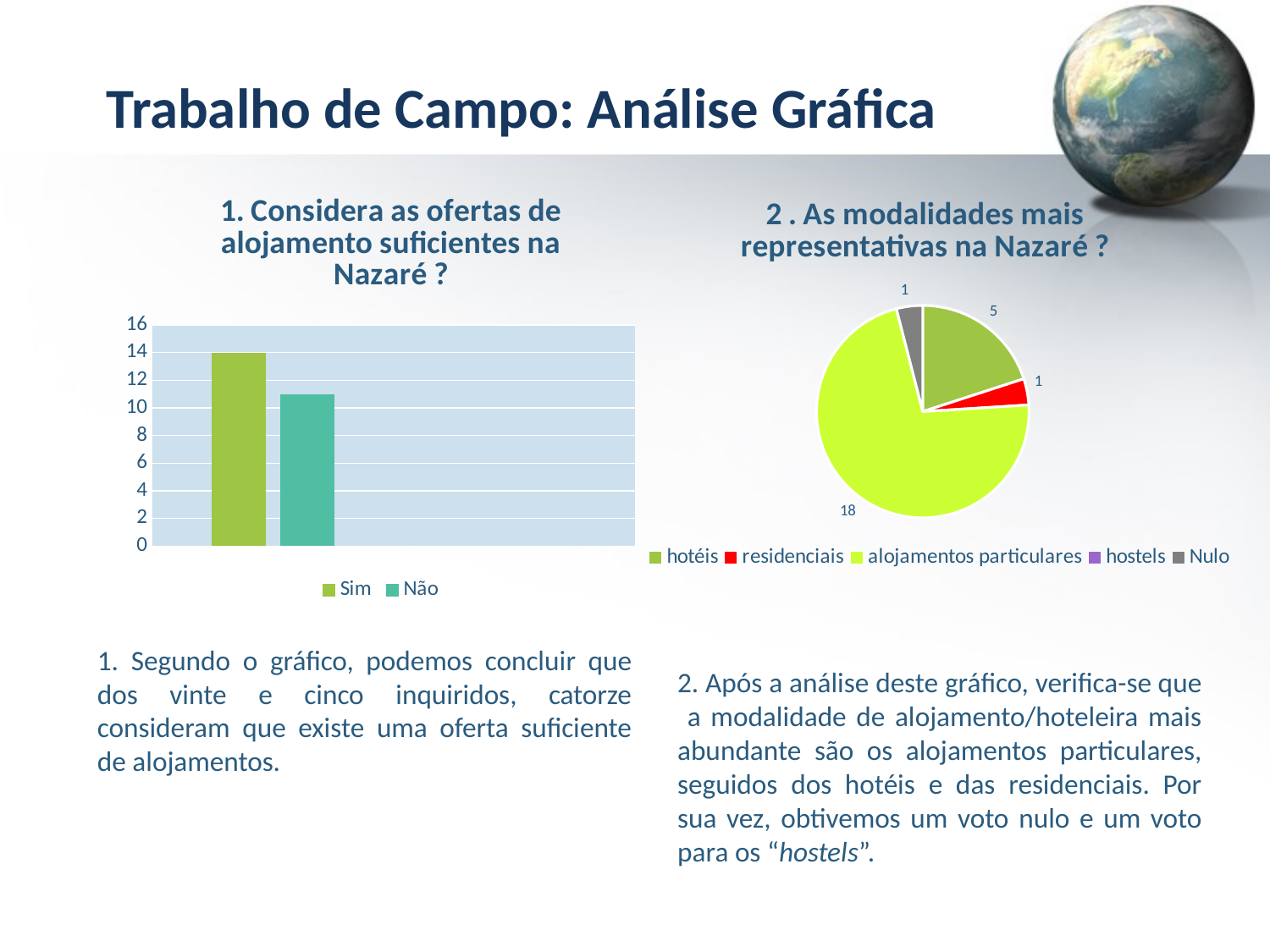
In the chart "1. Considera as ofertas de alojamento suficientes na Nazaré ?", which is larger, Sim or Não? Sim How many series does the legend of the chart "1. Considera as ofertas de alojamento suficientes na Nazaré ?" list? 2 What kind of chart is the chart titled "2 . As modalidades mais representativas na Nazaré ?"? pie chart In the pie chart "2 . As modalidades mais representativas na Nazaré ?", what is the difference between the values for hotéis and residenciais? 4 What kind of chart is the chart titled "1. Considera as ofertas de alojamento suficientes na Nazaré ?"? bar chart In the pie chart "2 . As modalidades mais representativas na Nazaré ?", which category has the largest slice? alojamentos particulares In the pie chart "2 . As modalidades mais representativas na Nazaré ?", what is the value for alojamentos particulares? 18 In the chart "1. Considera as ofertas de alojamento suficientes na Nazaré ?", is the value for Não greater or less than 12? less How many entries does the legend of the pie chart "2 . As modalidades mais representativas na Nazaré ?" list? 5 In the pie chart "2 . As modalidades mais representativas na Nazaré ?", what is the value for hotéis? 5 In the chart "1. Considera as ofertas de alojamento suficientes na Nazaré ?", what is the value for Sim? 14 In the pie chart "2 . As modalidades mais representativas na Nazaré ?", what colour is the residenciais slice? red